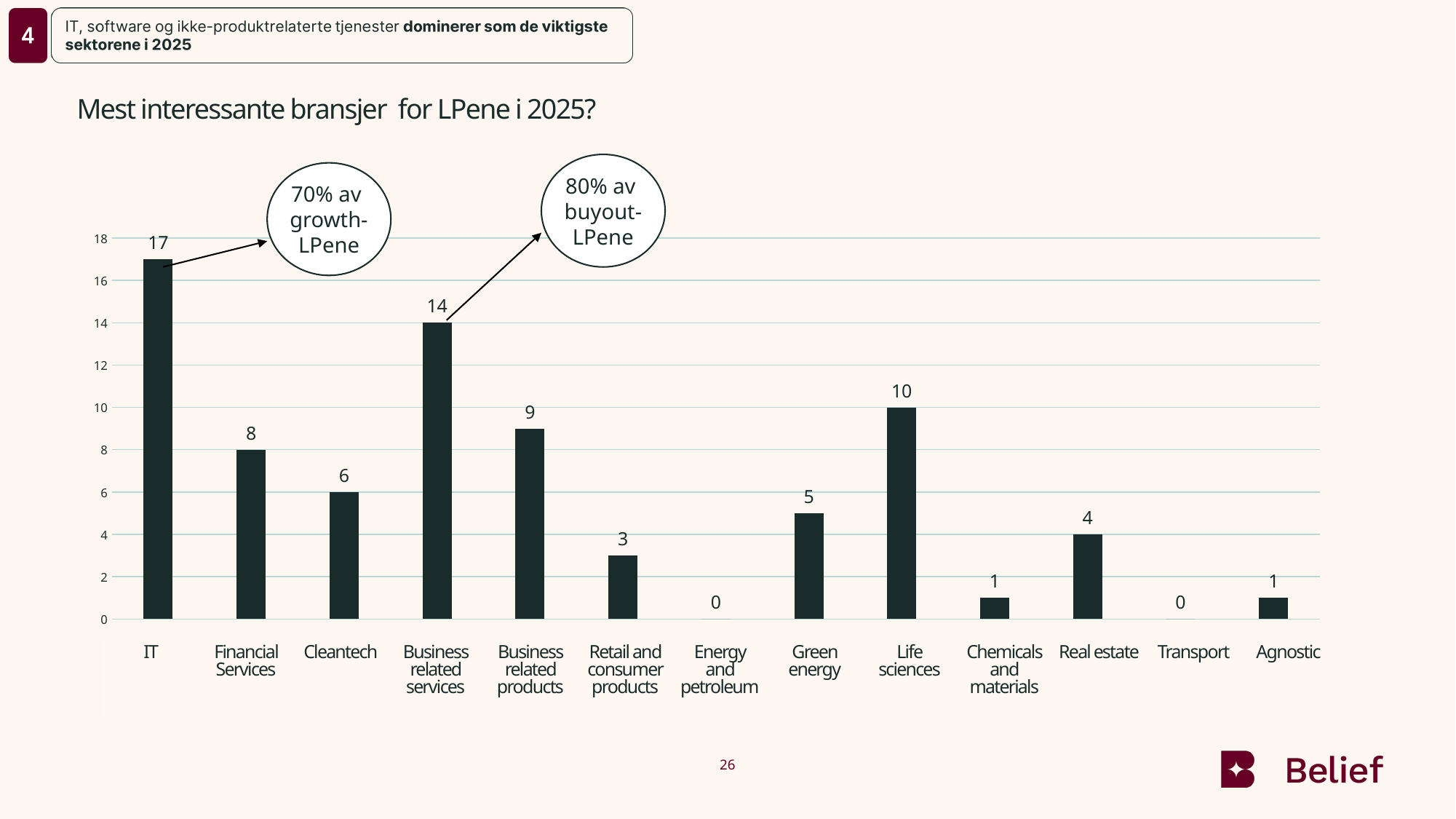
What is the value for Life sciences? 10 Is the value for Cleantech greater or less than 10? less What kind of chart is shown on the slide? bar chart Which categories have a value of 0? Energy and petroleum, Transport What is the value for IT? 17 Which is larger, the value for Financial Services or the value for Business related products? Business related products What is the title of the chart? Mest interessante bransjer for LPene i 2025? What is the value for Business related services? 14 How many categories are shown on the x axis? 13 What is the difference between the values for IT and Business related services? 3 What does the callout pointing to the Business related services bar say? 80% av buyout-LPene Which category has the highest value? IT